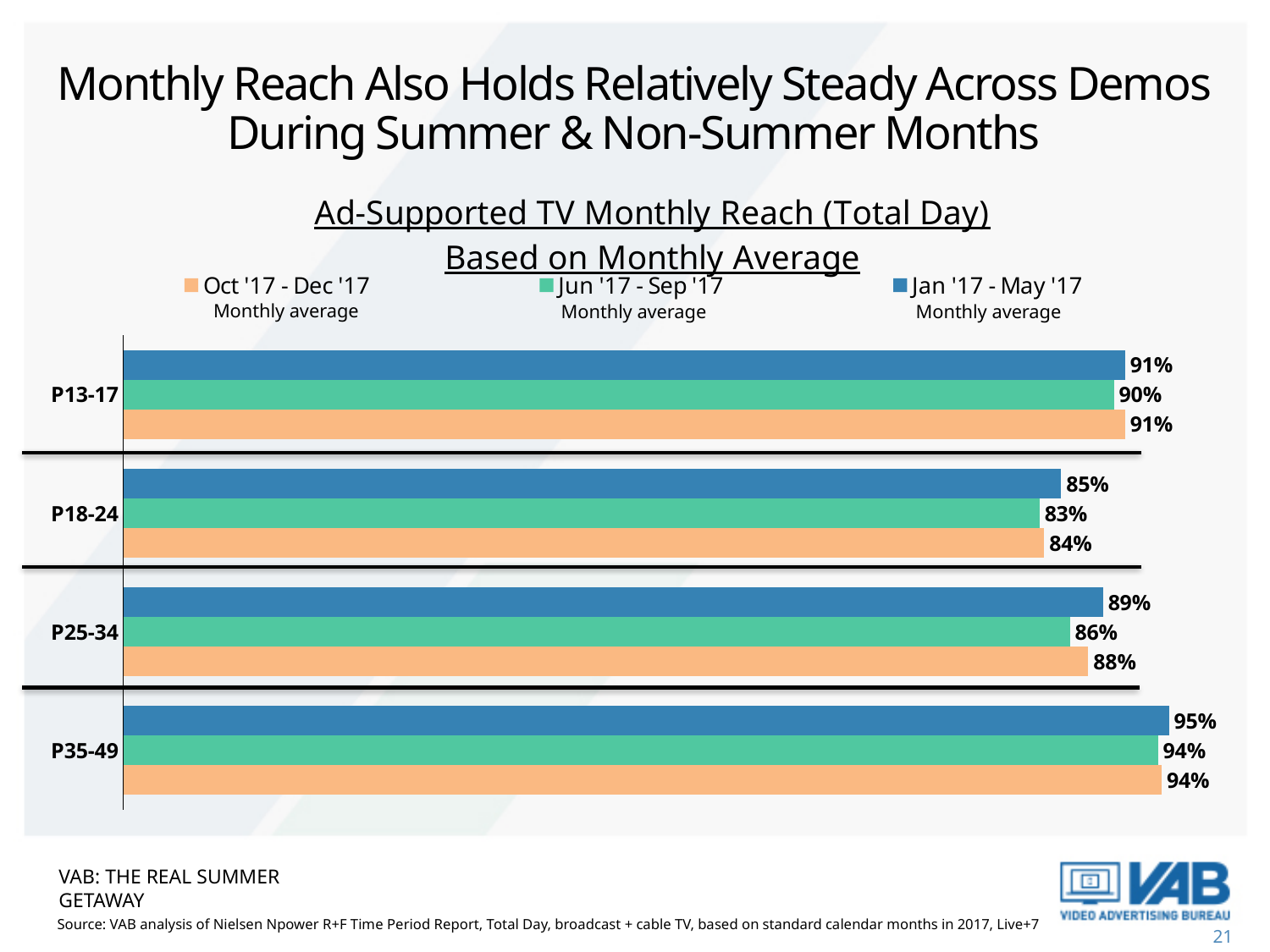
How many demo groups are shown on the chart? 4 What type of chart is shown on the slide? Bar chart Which demo has the highest Jan '17 - May '17 monthly average reach? P35-49 How many series does the legend list? 3 What is the Jun '17 - Sep '17 monthly average reach for P18-24? 83% What is the Oct '17 - Dec '17 monthly average reach for P25-34? 88% What is the Jan '17 - May '17 monthly average reach for P35-49? 95% What is the difference between the Jan '17 - May '17 and Jun '17 - Sep '17 values for P25-34? 3% Which demo has the lowest Jun '17 - Sep '17 monthly average reach? P18-24 Which colour represents the Jun '17 - Sep '17 monthly average series? Green What is the difference between the P35-49 and P18-24 values for Oct '17 - Dec '17? 10% For P18-24, which is larger: the Jan '17 - May '17 value or the Oct '17 - Dec '17 value? Jan '17 - May '17